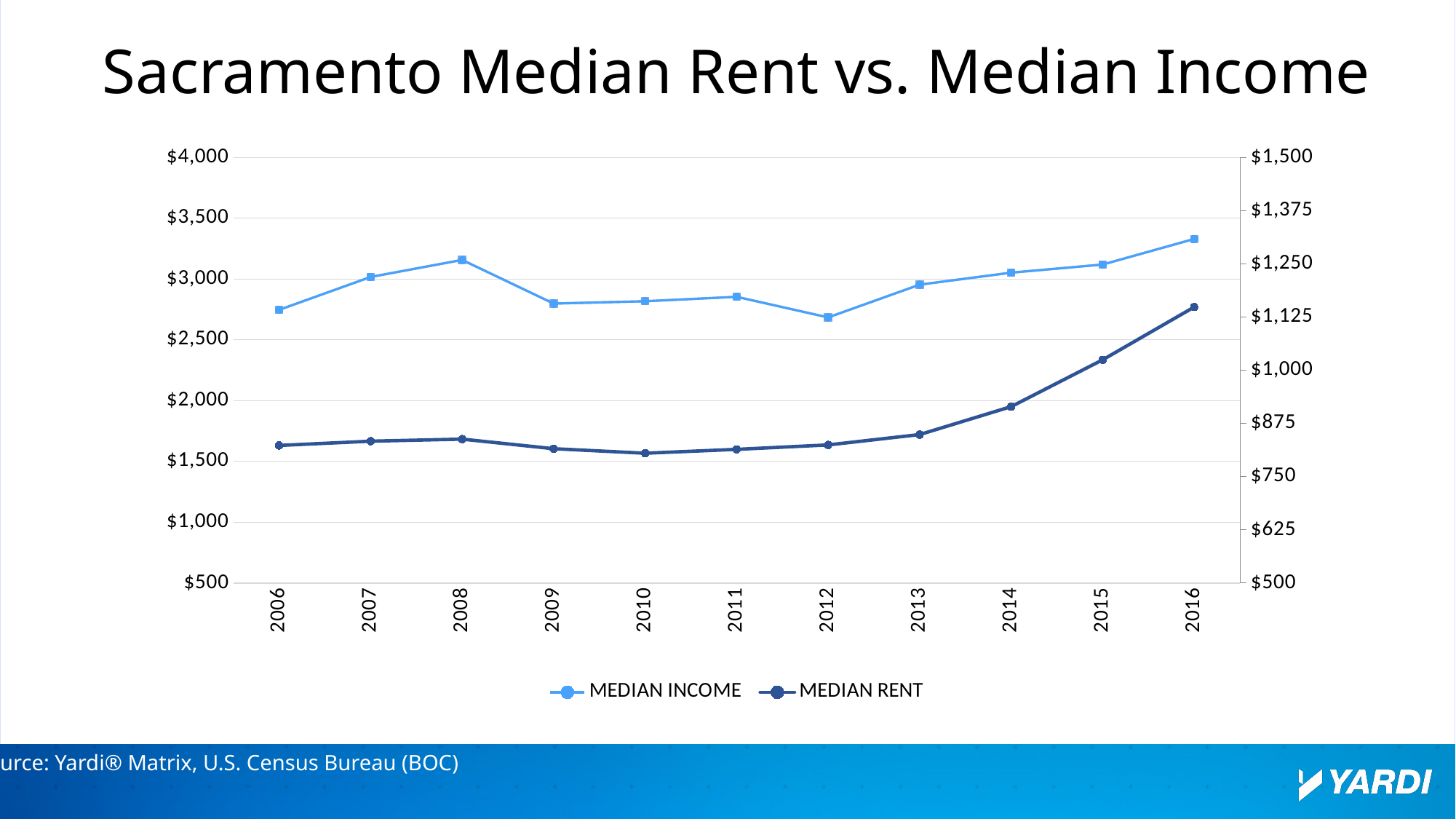
Which is higher, Median Income in 2008 or Median Income in 2009? 2008 Which is higher, Median Rent in 2016 or Median Rent in 2006? 2016 Does Median Rent rise or fall from 2013 to 2016? Rise Does Median Income rise or fall from 2008 to 2009? Fall In which year is Median Income at its highest? 2016 What is the title of the chart? Sacramento Median Rent vs. Median Income In which year is Median Income at its lowest? 2012 Reading the left-hand axis, is the Median Income value for 2012 greater or less than $2,500? greater How many series does the legend list? 2 What kind of chart is shown on the slide? Line chart How many years are plotted along the x axis? 11 In which year is Median Rent at its highest? 2016